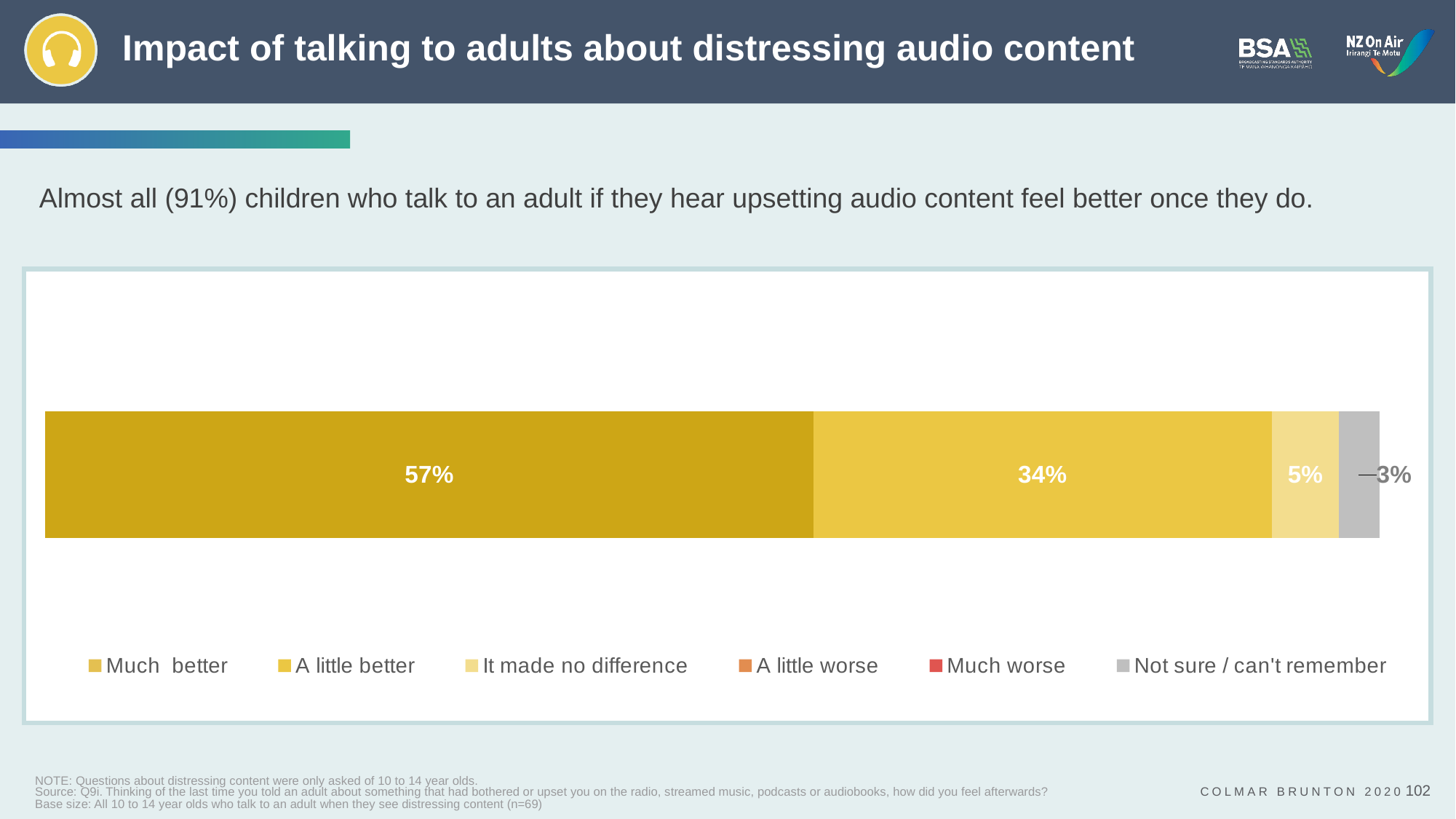
What colour is the 'Not sure / can't remember' segment? Grey What is the difference between the 'Much better' and 'A little better' percentages? 23 percentage points What percentage of children said they felt a little better? 34% Which response has the largest share of the bar? Much better What is the combined percentage of 'Much better' and 'A little better'? 91% Which labelled segment of the bar is the smallest? Not sure / can't remember Which is larger, the share for 'A little better' or the share for 'It made no difference'? A little better What kind of chart is shown on the slide? Stacked bar chart How many series does the legend list? 6 What percentage of children said they felt much better after talking to an adult? 57% What percentage of children said it made no difference? 5% What percentage of children were not sure or couldn't remember? 3%